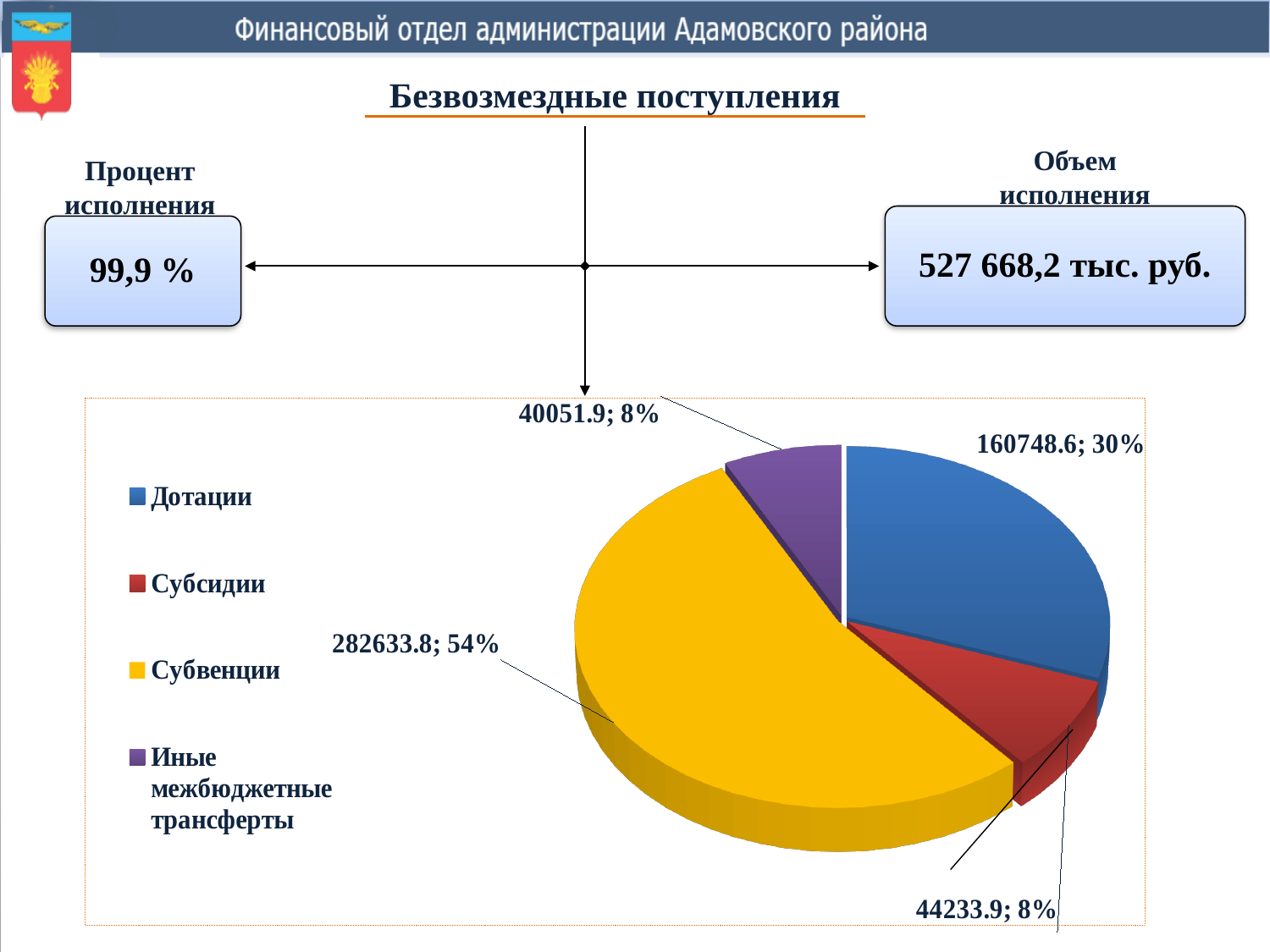
What share of the pie does Дотации represent? 30% Which category has the largest slice of the pie? Субвенции What is the value shown for Субвенции? 282633.8 How many slices does the pie chart have? 4 What kind of chart is shown on the slide? pie chart What is the value shown for Иные межбюджетные трансферты? 40051.9 What share of the pie does Субвенции represent? 54% What is the value shown for Субсидии? 44233.9 Which category has the smallest value in the pie chart? Иные межбюджетные трансферты What is the value shown for Дотации? 160748.6 Which colour represents Субсидии in the pie chart? red What is the difference between the values for Субвенции and Дотации? 121885.2